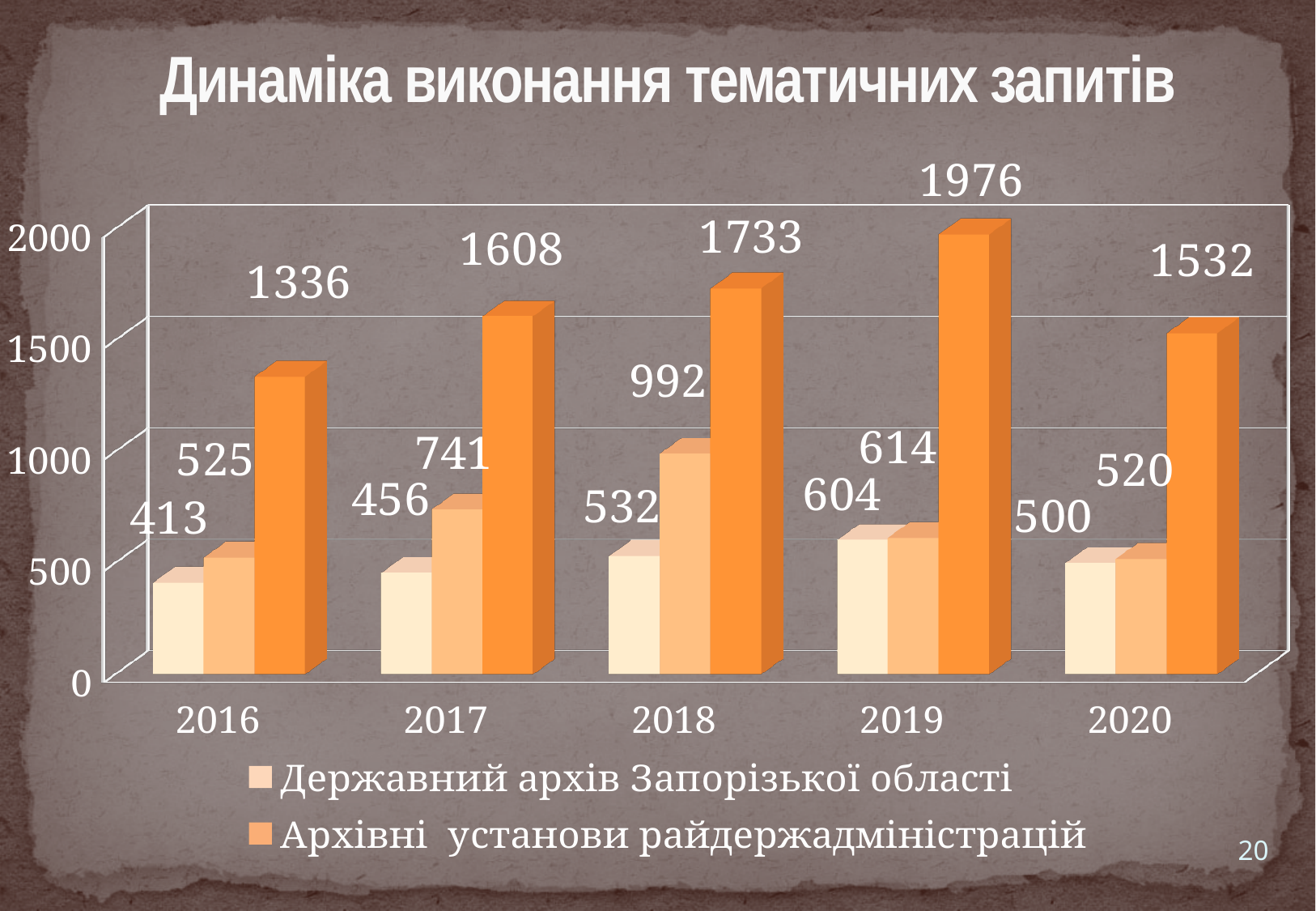
What is the value for Державний архів Запорізької області in 2016? 413 What is the value for Архівні установи райдержадміністрацій in 2018? 992 What is the difference between Архівні установи райдержадміністрацій and Державний архів Запорізької області in 2017? 285 Which is larger: the value for Державний архів Запорізької області in 2018 or in 2020? 2018 Is the value for Державний архів Запорізької області in 2017 greater or less than 500? less How many years are shown on the x axis? 5 What kind of chart is shown on the slide? bar chart In which year is the value for Архівні установи райдержадміністрацій the lowest? 2020 How many series does the legend list? 2 What is the value for Державний архів Запорізької області in 2019? 604 What is the title of the chart? Динаміка виконання тематичних запитів In which year is the value for Державний архів Запорізької області the highest? 2019